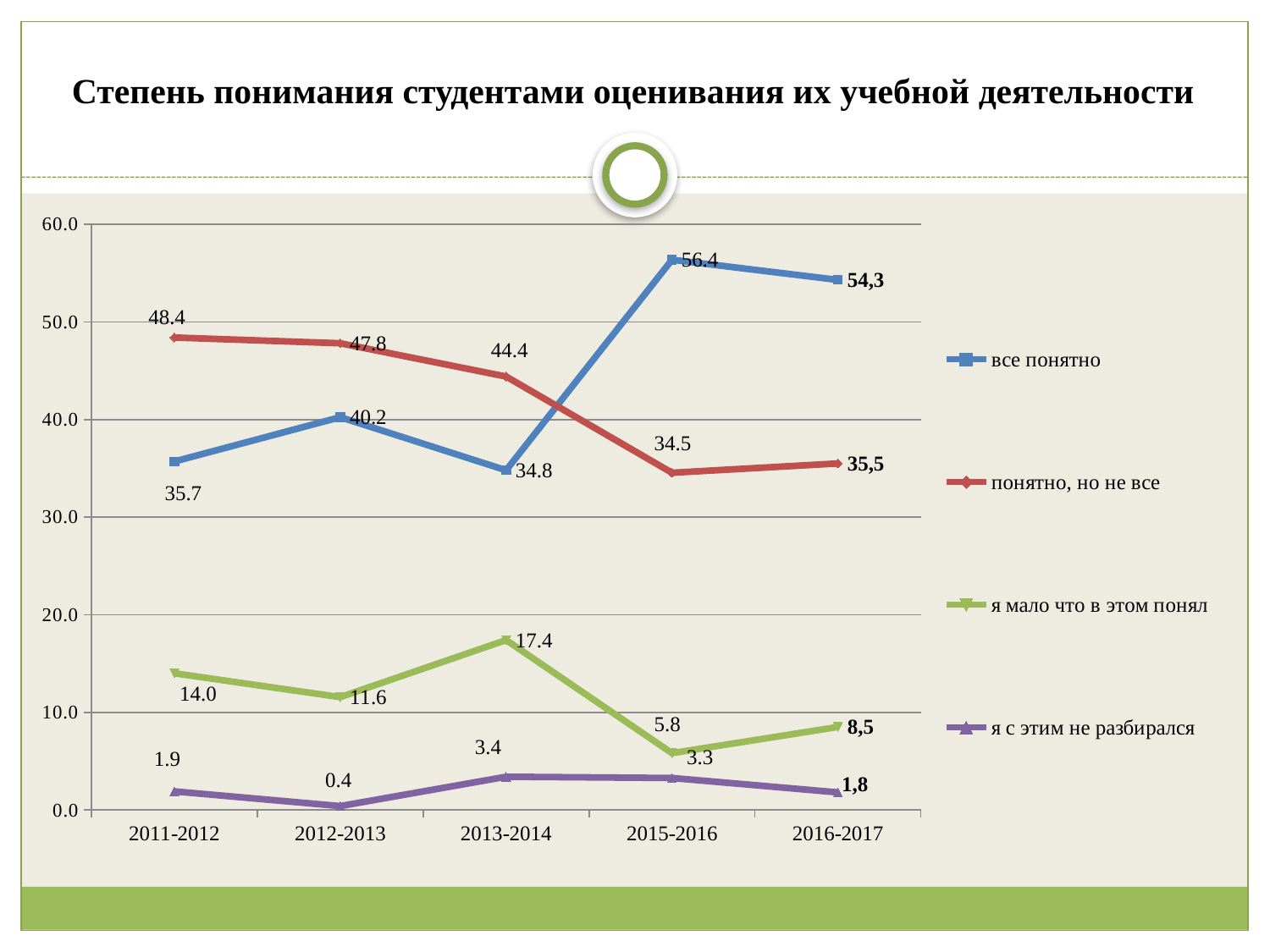
What type of chart is shown on the slide? line chart What is the value for "понятно, но не все" in 2011-2012? 48.4 What is the value for "я мало что в этом понял" in 2016-2017? 8,5 How many series does the legend list? 4 How many academic years are plotted on the x axis? 5 Which is larger in 2013-2014: "все понятно" or "понятно, но не все"? понятно, но не все Does the "понятно, но не все" series rise or fall from 2011-2012 to 2015-2016? fall In which year does "все понятно" reach its highest value? 2015-2016 In which year does "я мало что в этом понял" have its lowest value? 2015-2016 What is the difference between "все понятно" and "понятно, но не все" in 2015-2016? 21.9 What is the value for "все понятно" in 2015-2016? 56.4 What is the value for "я с этим не разбирался" in 2012-2013? 0.4